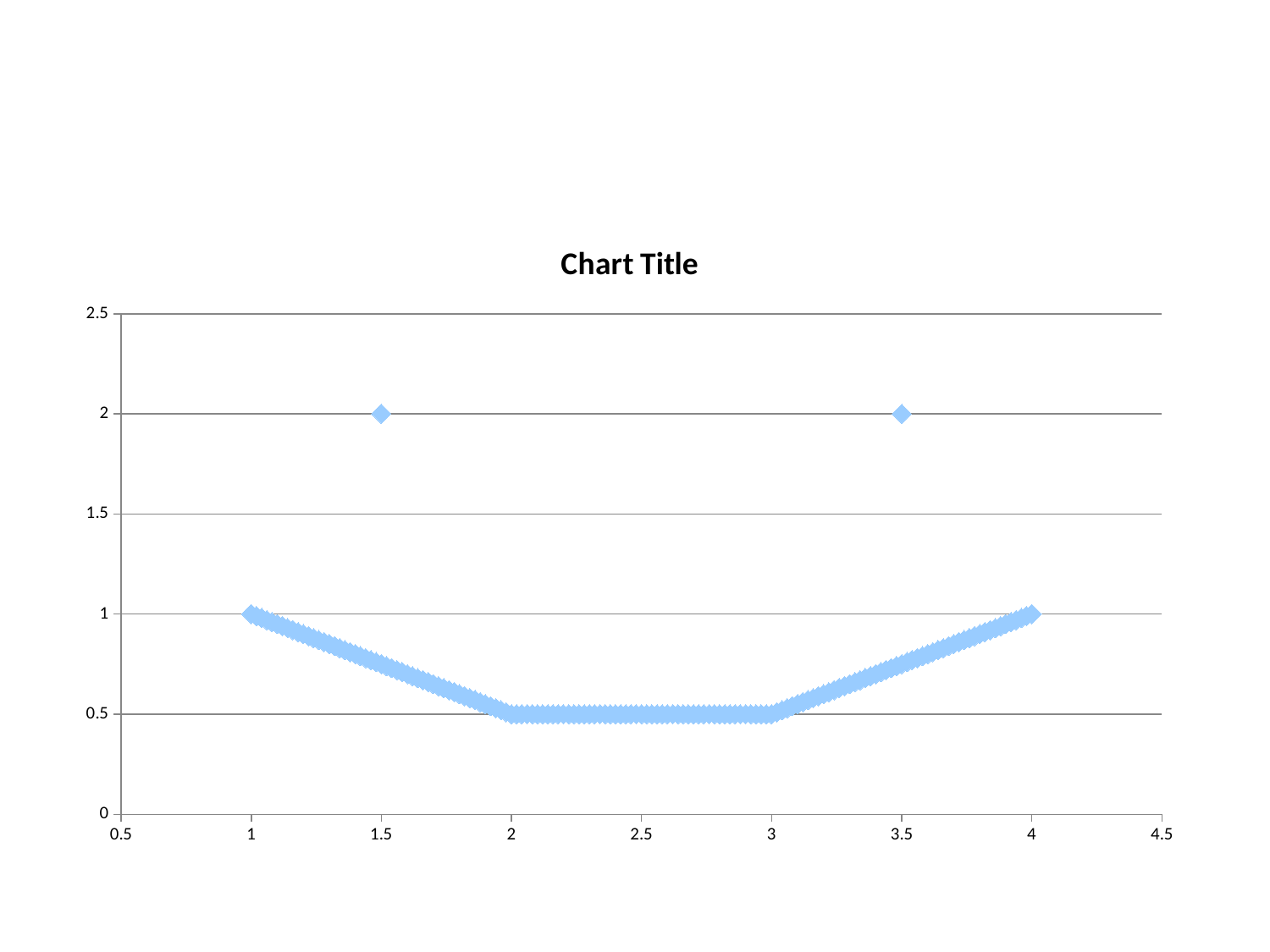
What kind of chart is shown on the slide? scatter chart What is the highest y value plotted on the chart? 2 What is the y value of the isolated point at x = 1.5? 2 How many isolated points are plotted above the y = 1.5 gridline? 2 What is the y value of the isolated point at x = 3.5? 2 Which has the larger y value: the point at x = 1.5 or the point at x = 2? the point at x = 1.5 What is the title of the chart? Chart Title What is the y value of the point at x = 1? 1 What is the y value of the point at x = 4? 1 What is the y value of the points at x = 2? 0.5 Do the y values of the dense band of points rise or fall as x goes from 1 to 2? fall Is the y value of the points at x = 2.5 greater or less than 1? less